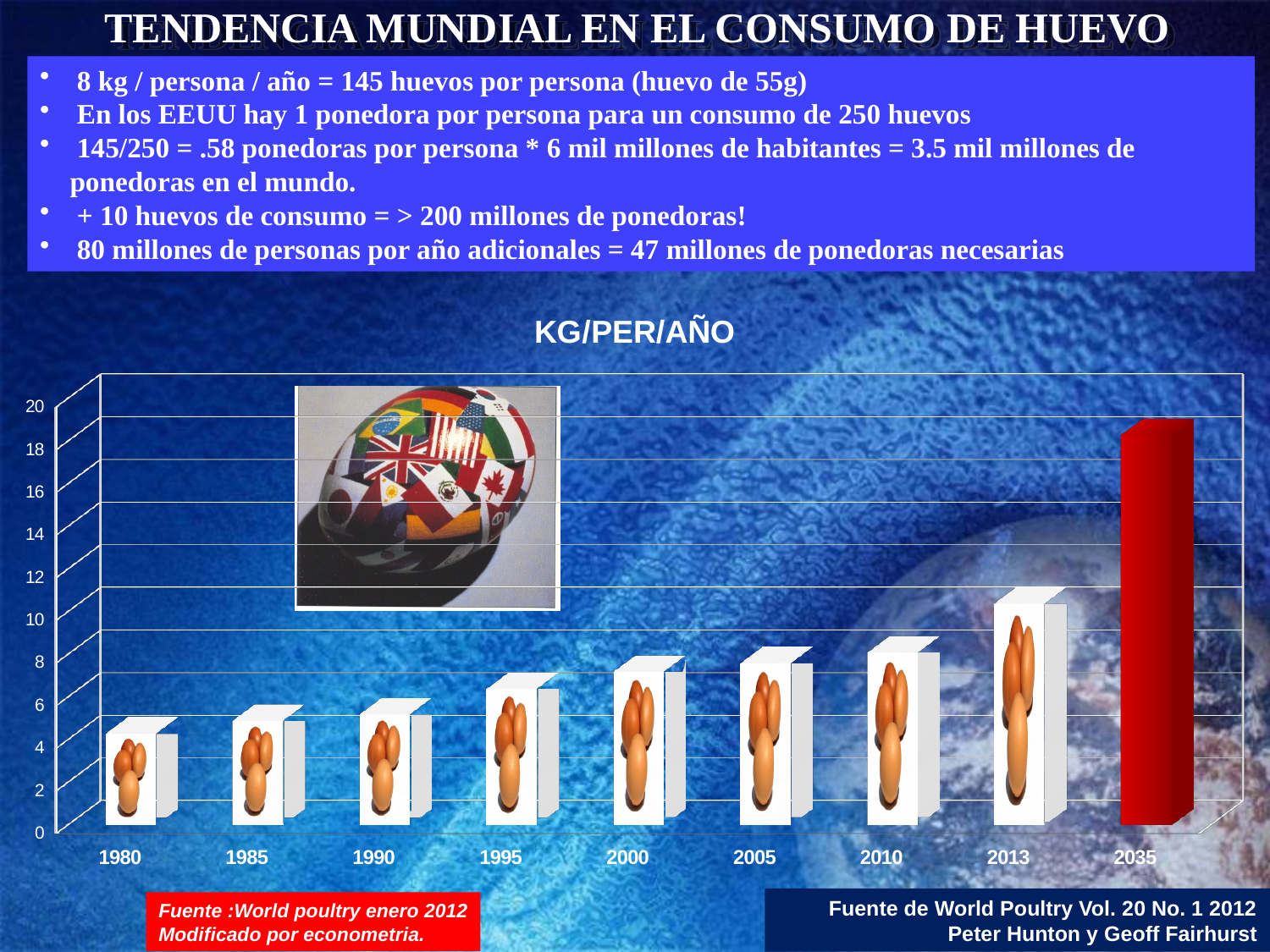
What colour is the bar for 2035? red What kind of chart is shown on the slide? bar chart Do the values rise or fall from 1980 to 2035? rise Is the value for 1980 greater or less than 6? less Is the value for 2013 greater or less than 8? greater Which year has the highest value in the chart? 2035 How many years are shown on the x axis of the chart? 9 Is the value for 2010 greater or less than 12? less What is the title of the chart? KG/PER/AÑO Which is larger, the value for 2013 or the value for 1990? 2013 Which year has the lowest value in the chart? 1980